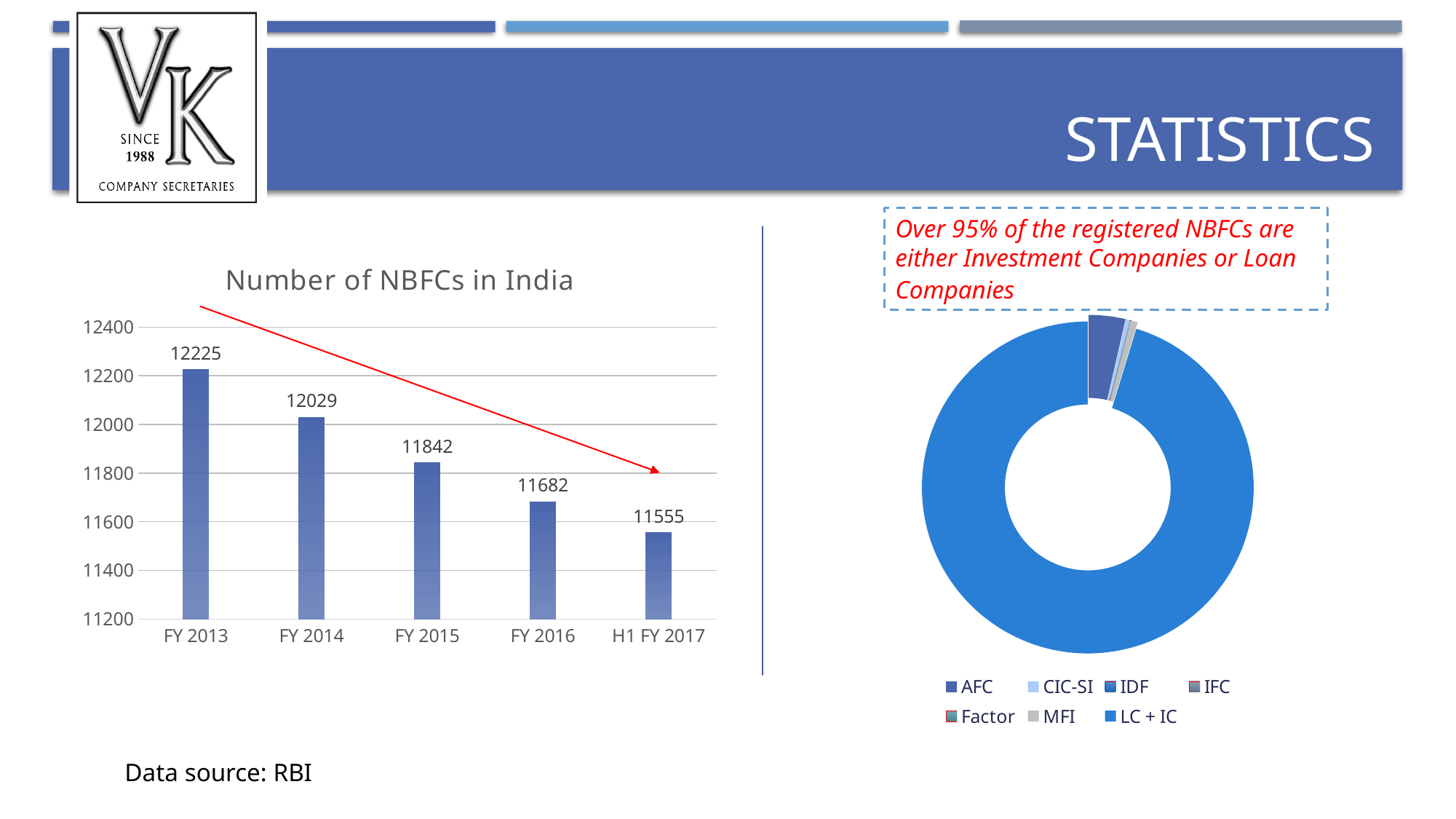
In the 'Number of NBFCs in India' chart, which is larger, the value for FY 2014 or FY 2016? FY 2014 In the 'Number of NBFCs in India' chart, what is the value for FY 2015? 11842 In the 'Number of NBFCs in India' chart, what is the value for H1 FY 2017? 11555 How many categories does the legend of the doughnut chart on the right list? 7 In the 'Number of NBFCs in India' chart, what is the value for FY 2013? 12225 What kind of chart is 'Number of NBFCs in India'? Bar chart In the 'Number of NBFCs in India' chart, what is the difference between the FY 2016 and H1 FY 2017 values? 127 In the 'Number of NBFCs in India' chart, which period has the highest value? FY 2013 In the 'Number of NBFCs in India' chart, how many periods are shown on the x axis? 5 In the 'Number of NBFCs in India' chart, do the values rise or fall from FY 2013 to H1 FY 2017? Fall In the 'Number of NBFCs in India' chart, what is the difference between the FY 2013 and FY 2014 values? 196 In the 'Number of NBFCs in India' chart, which period has the lowest value? H1 FY 2017